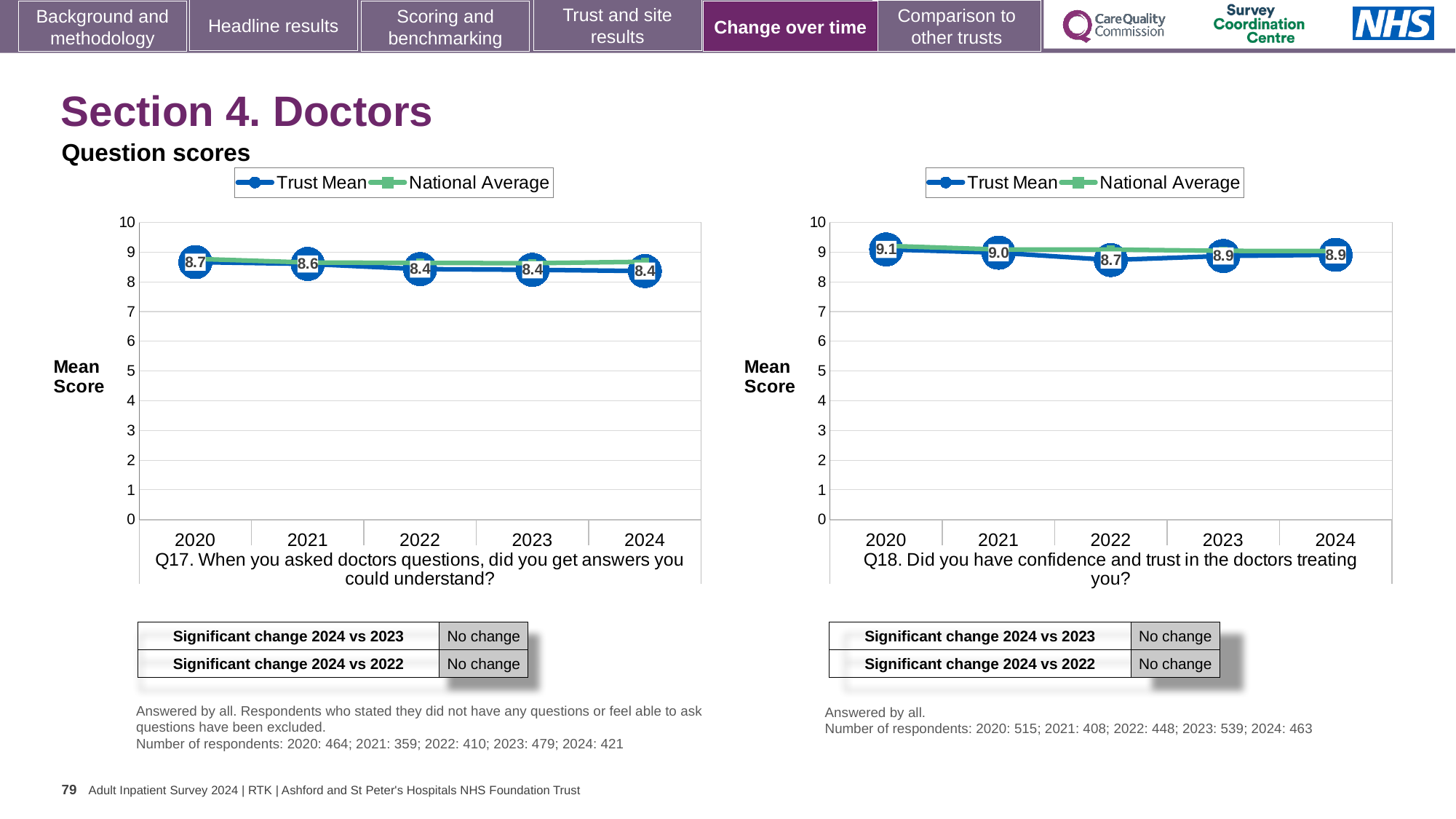
In the Q17 chart (left), which year has the highest Trust Mean score? 2020 In the Q17 chart (left), what is the difference between the Trust Mean scores for 2020 and 2024? 0.3 How many series does the legend of the Q17 chart (left) list? 2 In the Q18 chart (right), which year has the lowest Trust Mean score? 2022 What kind of chart is the Q18 chart (right)? Line chart How many years are shown on the x axis of the Q18 chart (right)? 5 In the Q17 chart (left), what is the Trust Mean score for 2020? 8.7 In the Q17 chart (left), what is the Trust Mean score for 2024? 8.4 In the Q17 chart (left), is the National Average value for 2024 greater or less than 8? greater In the Q18 chart (right), what is the Trust Mean score for 2024? 8.9 In the Q18 chart (right), what is the Trust Mean score for 2022? 8.7 In the Q18 chart (right), which is larger, the Trust Mean score for 2020 or for 2022? 2020